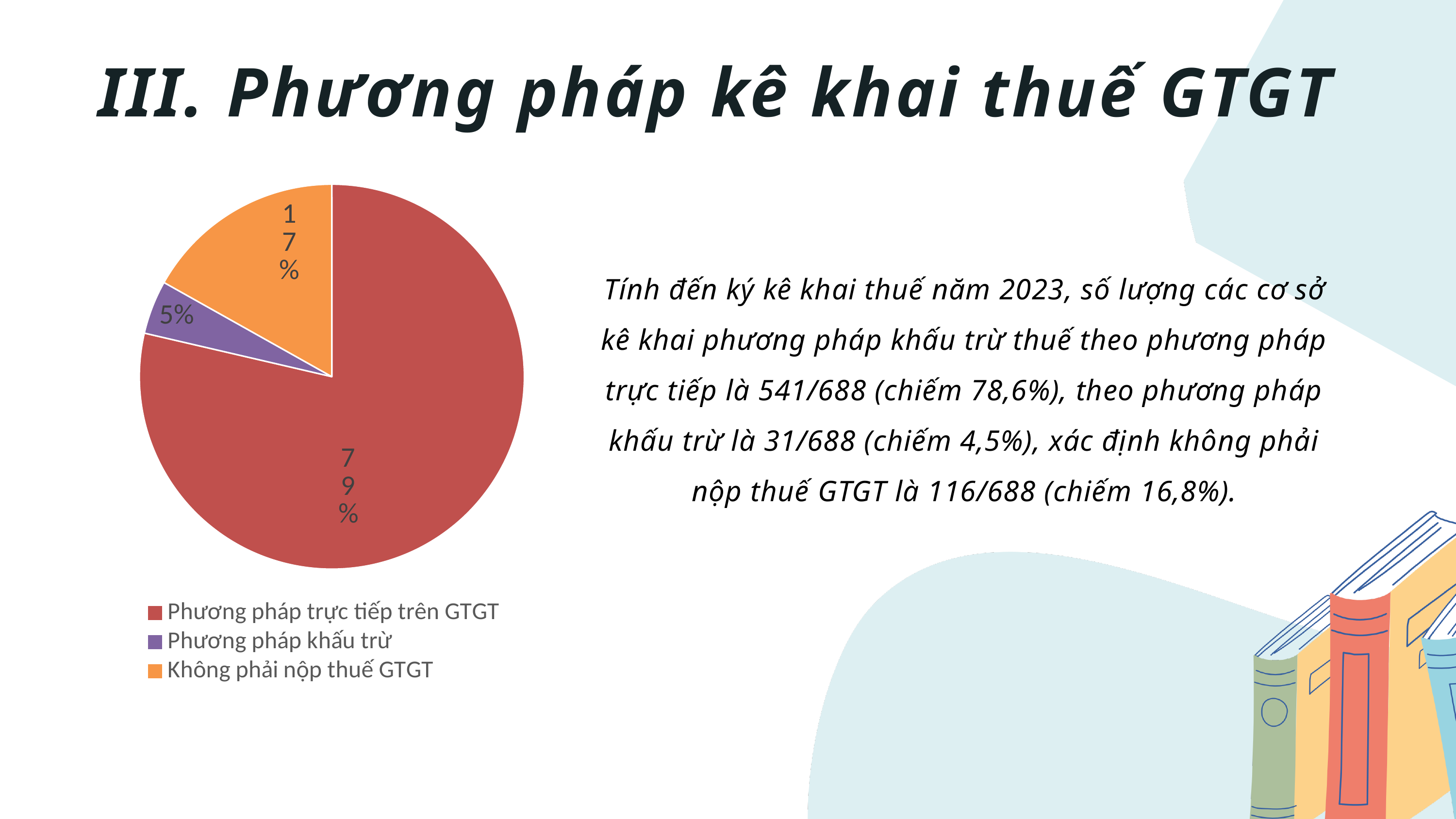
What percentage of the pie chart is labelled for Phương pháp trực tiếp trên GTGT? 79% How many slices does the pie chart have? 3 What percentage of the pie chart is labelled for Phương pháp khấu trừ? 5% What is the difference in percentage points between the Không phải nộp thuế GTGT slice and the Phương pháp khấu trừ slice? 12 What colour is the slice for Không phải nộp thuế GTGT? Orange What percentage of the pie chart is labelled for Không phải nộp thuế GTGT? 17% What type of chart is shown on the slide? Pie chart How many entries does the chart legend list? 3 Which slice is larger: Không phải nộp thuế GTGT or Phương pháp khấu trừ? Không phải nộp thuế GTGT Which category has the largest slice of the pie chart? Phương pháp trực tiếp trên GTGT What is the difference in percentage points between the Phương pháp trực tiếp trên GTGT slice and the Không phải nộp thuế GTGT slice? 62 Which category has the smallest slice of the pie chart? Phương pháp khấu trừ